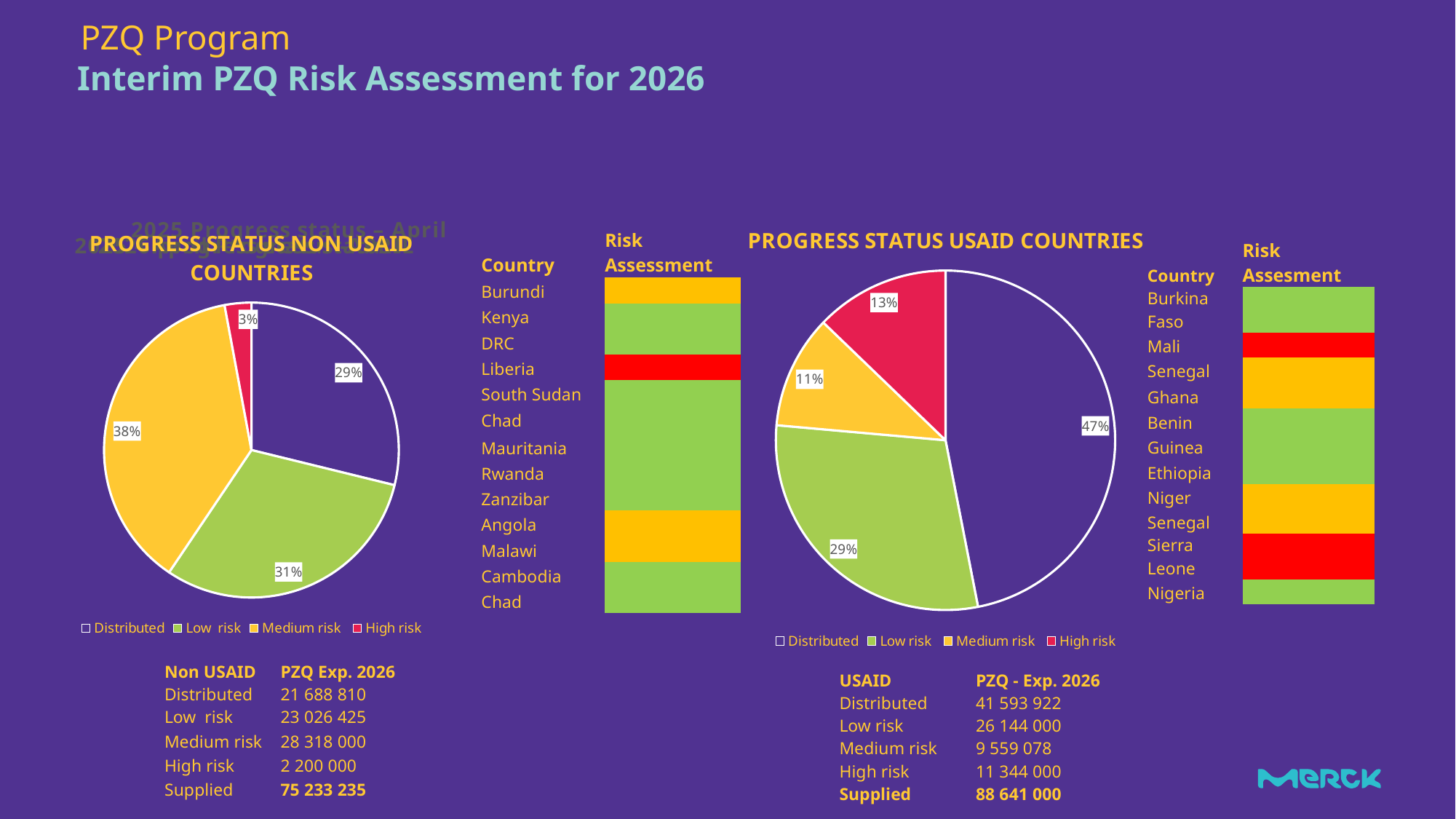
What type of chart is used for PROGRESS STATUS NON USAID COUNTRIES? Pie chart In the PROGRESS STATUS NON USAID COUNTRIES chart, what share of the pie is Medium risk? 38% How many slices does the PROGRESS STATUS USAID COUNTRIES pie chart have? 4 In the PROGRESS STATUS NON USAID COUNTRIES chart, what share of the pie is High risk? 3% In the PROGRESS STATUS NON USAID COUNTRIES chart, which category has the largest slice? Medium risk In the PROGRESS STATUS USAID COUNTRIES chart, what share of the pie is Medium risk? 11% In the PROGRESS STATUS USAID COUNTRIES chart, which category has the smallest slice? Medium risk In the PROGRESS STATUS NON USAID COUNTRIES chart, which is larger, Low risk or Distributed? Low risk How many entries does the legend of the PROGRESS STATUS USAID COUNTRIES chart list? 4 In the PROGRESS STATUS USAID COUNTRIES chart, what share of the pie is Distributed? 47% In the PROGRESS STATUS NON USAID COUNTRIES chart, which category has the smallest slice? High risk In the PROGRESS STATUS USAID COUNTRIES chart, what is the difference in percentage points between Distributed and Low risk? 18